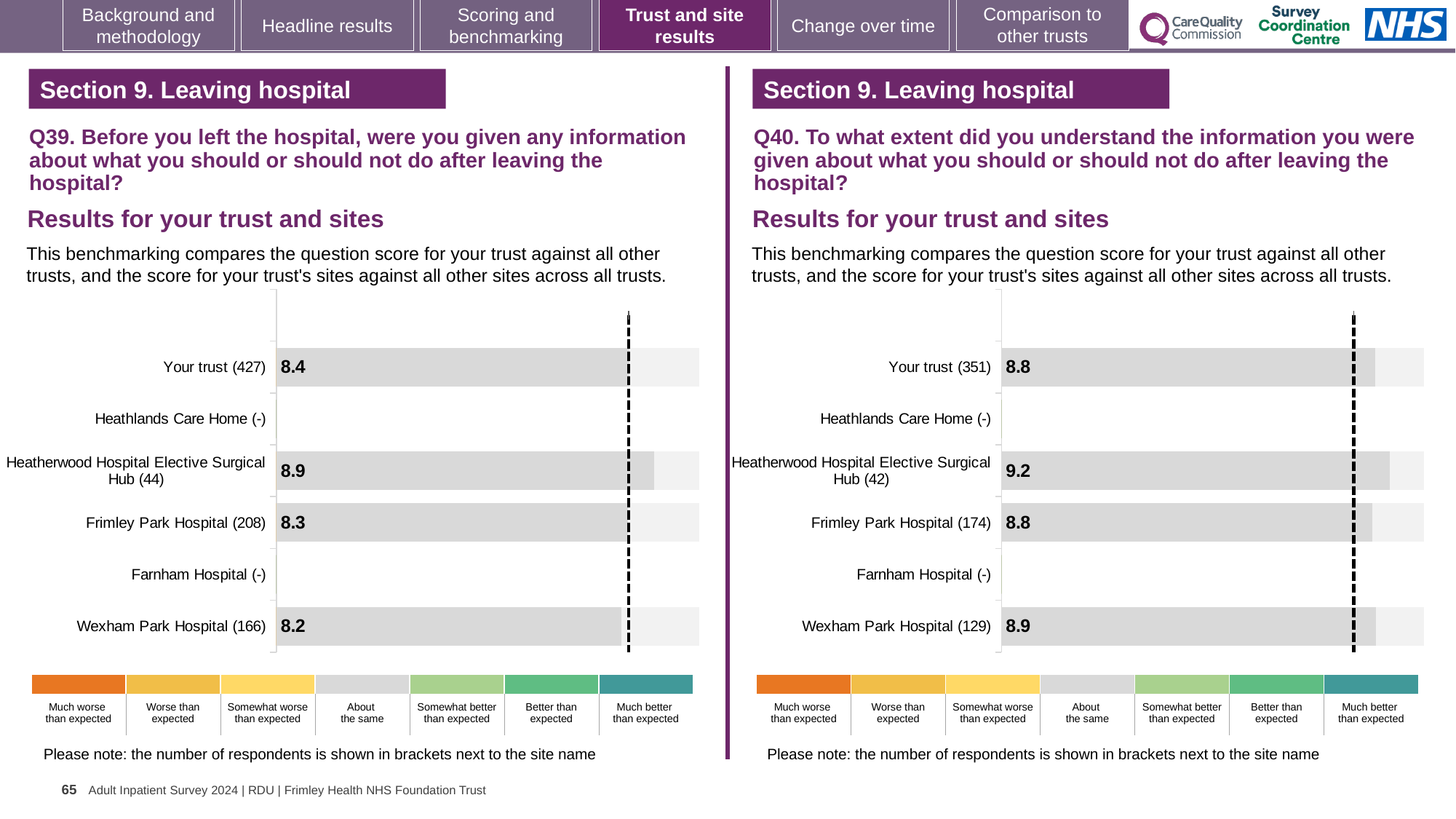
In the Q39 chart on the left, which site has the lowest score? Wexham Park Hospital (166) In the Q39 chart on the left, what is the score for Your trust (427)? 8.4 In the Q39 chart on the left, what is the difference between the scores for Heatherwood Hospital Elective Surgical Hub (44) and Frimley Park Hospital (208)? 0.6 In the Q40 chart on the right, is the score for Wexham Park Hospital (129) larger or smaller than the score for Frimley Park Hospital (174)? larger What type of chart is used in the Q40 chart on the right? Bar chart In the Q40 chart on the right, what is the score for Wexham Park Hospital (129)? 8.9 In the Q40 chart on the right, what is the difference between the scores for Heatherwood Hospital Elective Surgical Hub (42) and Your trust (351)? 0.4 In the Q40 chart on the right, which site has the highest score? Heatherwood Hospital Elective Surgical Hub (42) In the Q39 chart on the left, which site has the highest score? Heatherwood Hospital Elective Surgical Hub (44) In the Q40 chart on the right, what is the score for Heatherwood Hospital Elective Surgical Hub (42)? 9.2 How many site rows (including the trust row) are listed in the Q39 chart on the left? 6 In the Q39 chart on the left, what is the score for Heatherwood Hospital Elective Surgical Hub (44)? 8.9